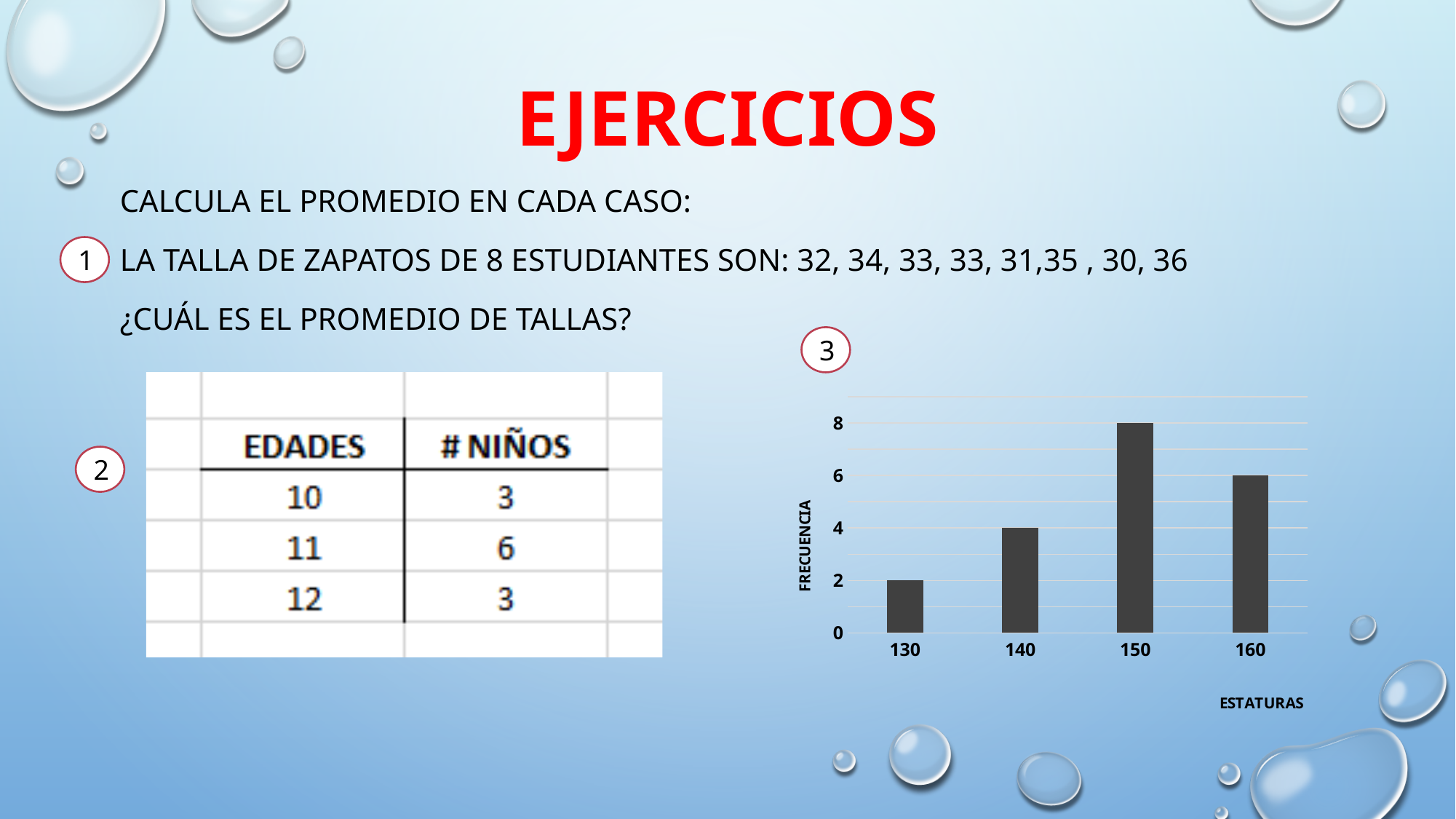
Which height has the highest frequency in the bar chart? 150 Which height has the lowest frequency in the bar chart? 130 What is the frequency for the height 160 in the bar chart? 6 What is the label of the vertical axis of the bar chart? FRECUENCIA What kind of chart is shown on the slide? bar chart What is the frequency for the height 130 in the bar chart? 2 Which has a higher frequency, height 140 or height 160? 160 What is the label of the horizontal axis of the bar chart? ESTATURAS What is the difference between the frequencies for heights 150 and 140? 4 Is the frequency for height 140 greater or less than 6? less What is the frequency for the height 150 in the bar chart? 8 How many height categories are shown on the x axis of the bar chart? 4